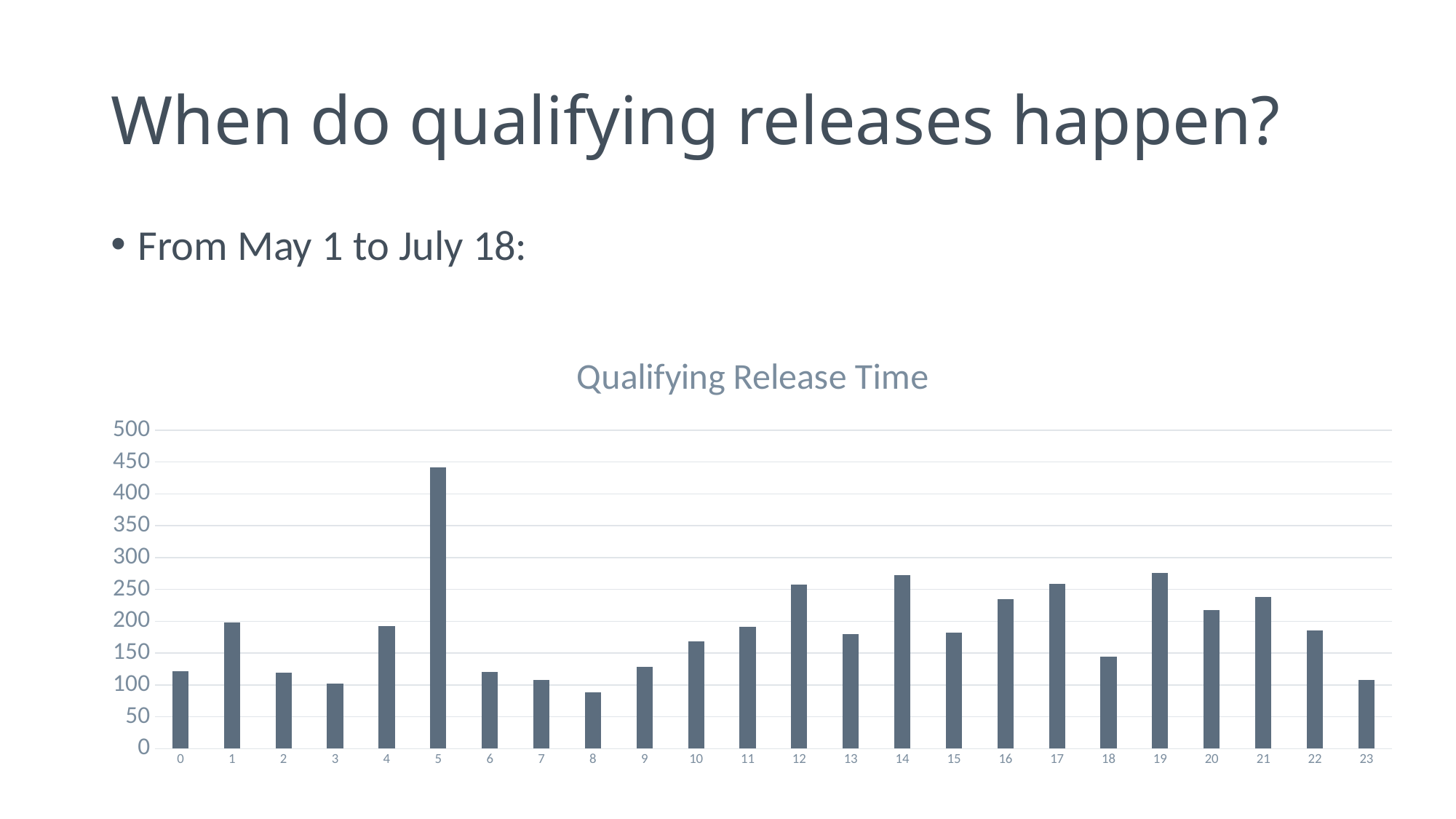
Is the value for hour 18 greater or less than 200? less What type of chart is shown on the slide? bar chart What is the highest value shown on the y axis? 500 Which has a larger value, hour 16 or hour 8? hour 16 How many categories (hours) are plotted on the x axis? 24 Which hour has the lowest number of qualifying releases? 8 What is the title of the chart? Qualifying Release Time Is the value for hour 14 greater or less than 250? greater Is the value for hour 5 greater or less than 400? greater Which hour has the highest number of qualifying releases? 5 Which has a larger value, hour 5 or hour 19? hour 5